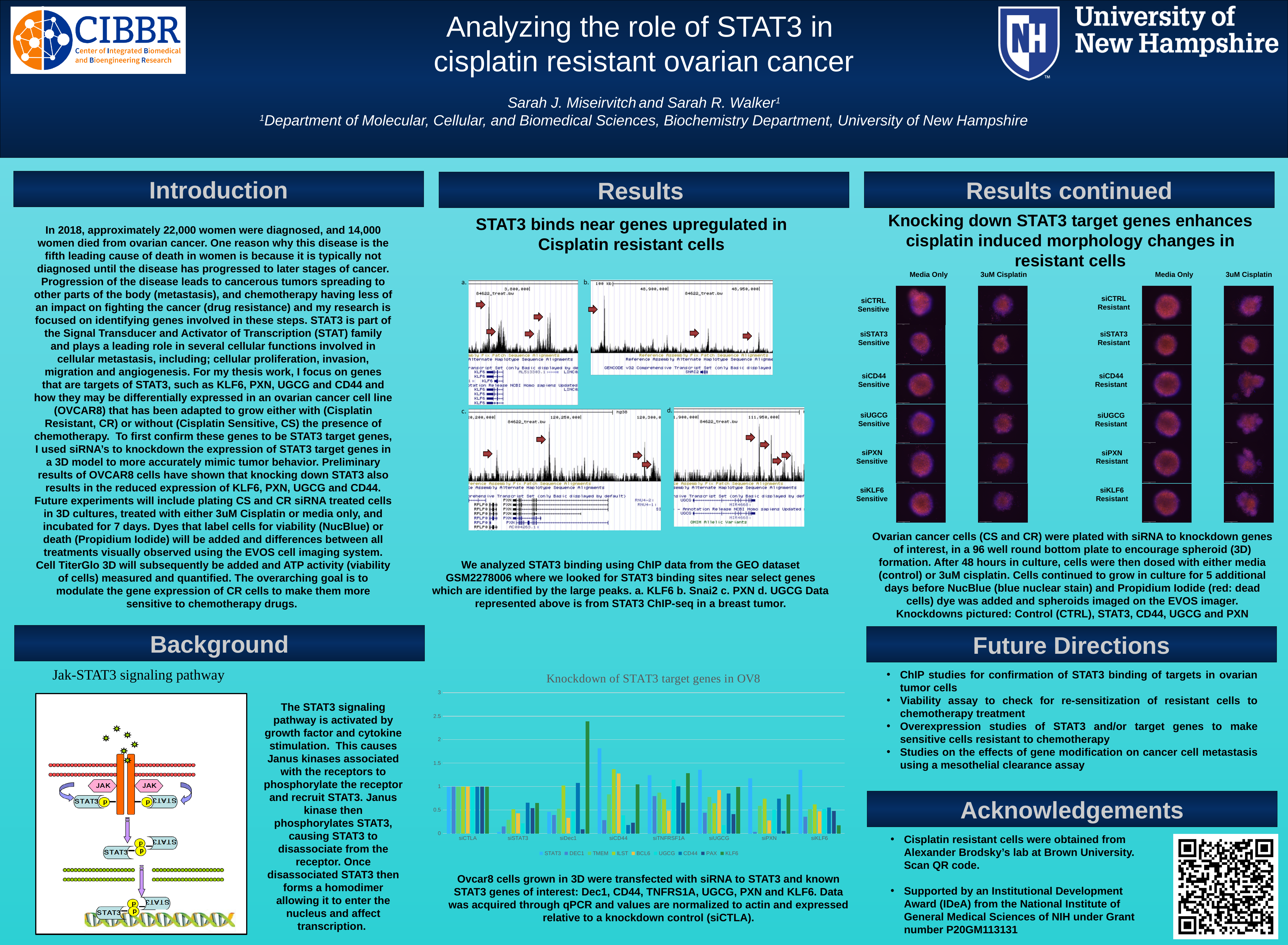
In the "Knockdown of STAT3 target genes in OV8" chart, is the STAT3 value for siKLF6 greater or less than 1? greater What kind of chart is "Knockdown of STAT3 target genes in OV8"? bar chart How many knockdown categories are shown on the x axis of the "Knockdown of STAT3 target genes in OV8" chart? 8 How many series does the legend of the "Knockdown of STAT3 target genes in OV8" chart list? 9 In the "Knockdown of STAT3 target genes in OV8" chart, which series has the tallest bar within the siDec1 group? KLF6 In the "Knockdown of STAT3 target genes in OV8" chart, is the KLF6 value for siDec1 greater or less than 2? greater In the "Knockdown of STAT3 target genes in OV8" chart, is the STAT3 value for siCD44 greater or less than 1.5? greater What is the title of the bar chart at the bottom of the Results column? Knockdown of STAT3 target genes in OV8 In the "Knockdown of STAT3 target genes in OV8" chart, which knockdown category contains the tallest bar? siDec1 In the "Knockdown of STAT3 target genes in OV8" chart, for siCD44, which is larger: the STAT3 bar or the DEC1 bar? STAT3 In the "Knockdown of STAT3 target genes in OV8" chart, what is the value of the STAT3 series for siCTLA? 1